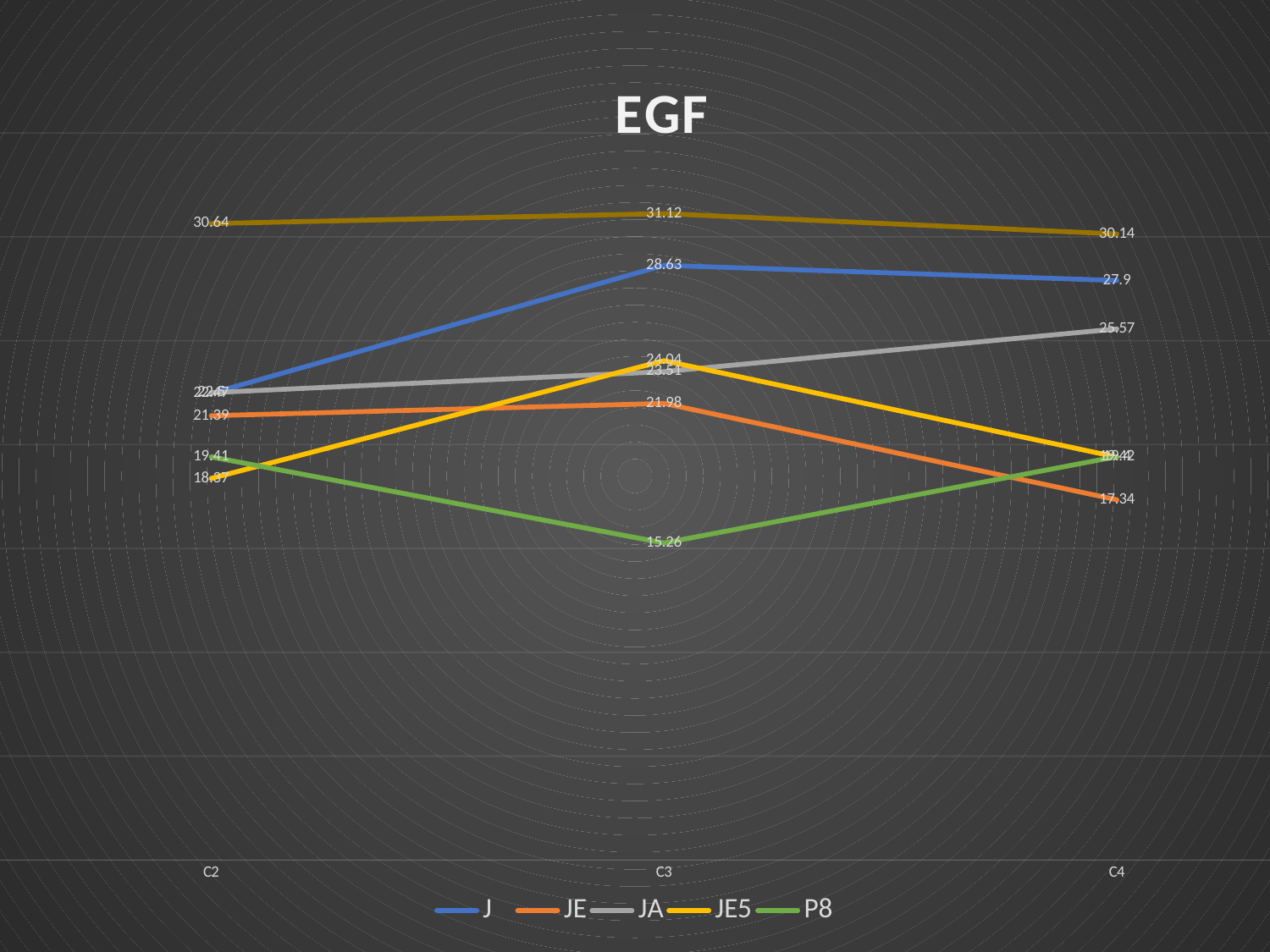
Does the JA series rise or fall from C2 to C4? rise How many categories are shown on the x axis? 3 What is the value of P8 at C3? 15.26 What is the title of the chart? EGF How many series does the legend list? 5 What kind of chart is shown on the slide? line chart What is the value of JE at C4? 17.34 What is the value of JE5 at C3? 24.04 What is the value of JA at C4? 25.57 At C3, which is larger, JE5 or JE? JE5 What is the difference between the J values at C3 and C4? 0.73 What is the value of J at C3? 28.63